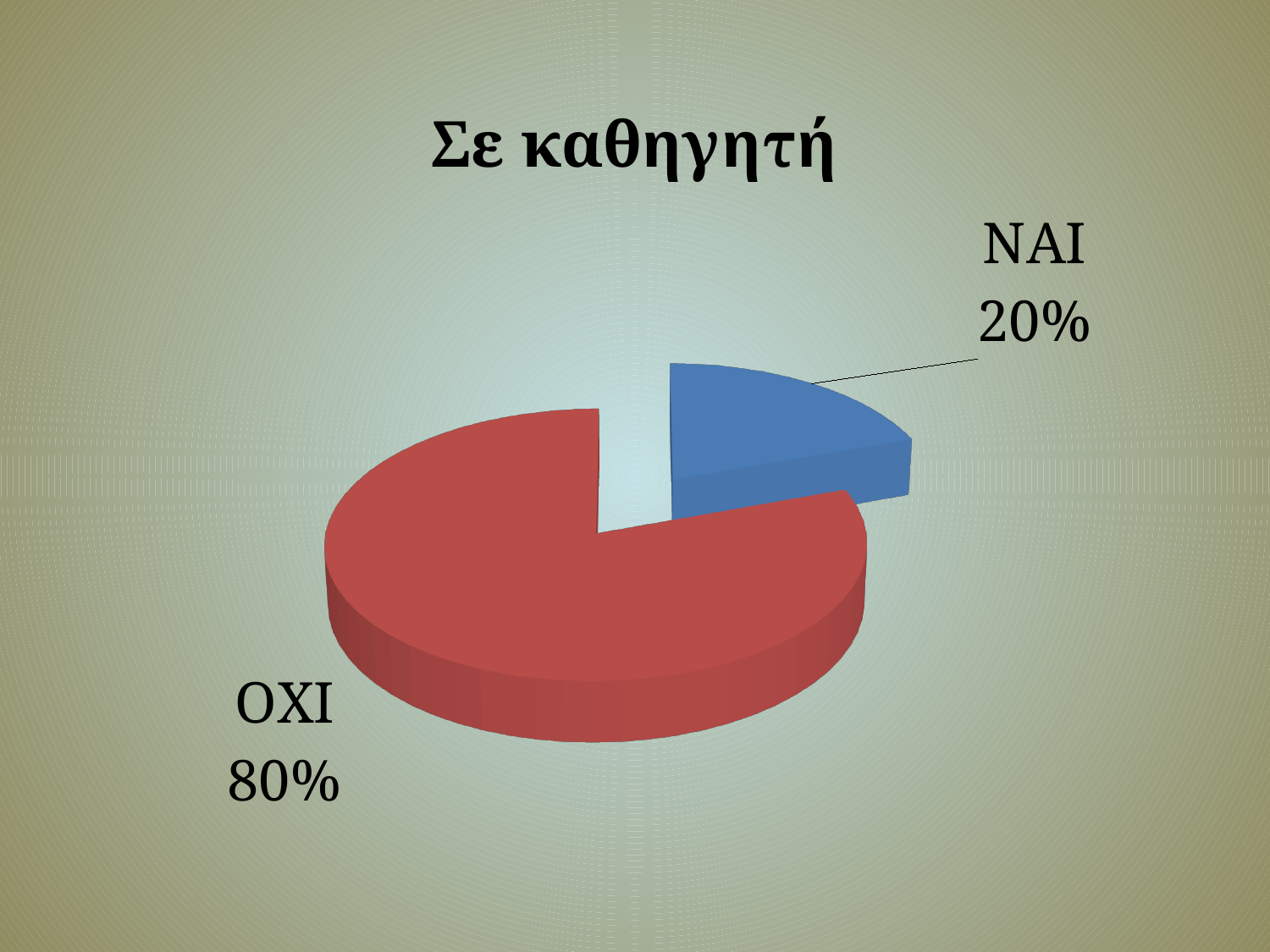
Which category has the largest share of the pie? ΟΧΙ How many slices does the pie chart have? 2 What share of the pie does the ΟΧΙ slice represent? 80% What is the difference in percentage points between ΟΧΙ and ΝΑΙ? 60 What percentage is shown for ΝΑΙ? 20% What kind of chart is shown on the slide? pie chart Which is larger, the share for ΝΑΙ or the share for ΟΧΙ? ΟΧΙ What is the title of the chart? Σε καθηγητή What colour is the ΝΑΙ slice? blue What percentage is shown for ΟΧΙ? 80% Which category has the smallest share of the pie? ΝΑΙ